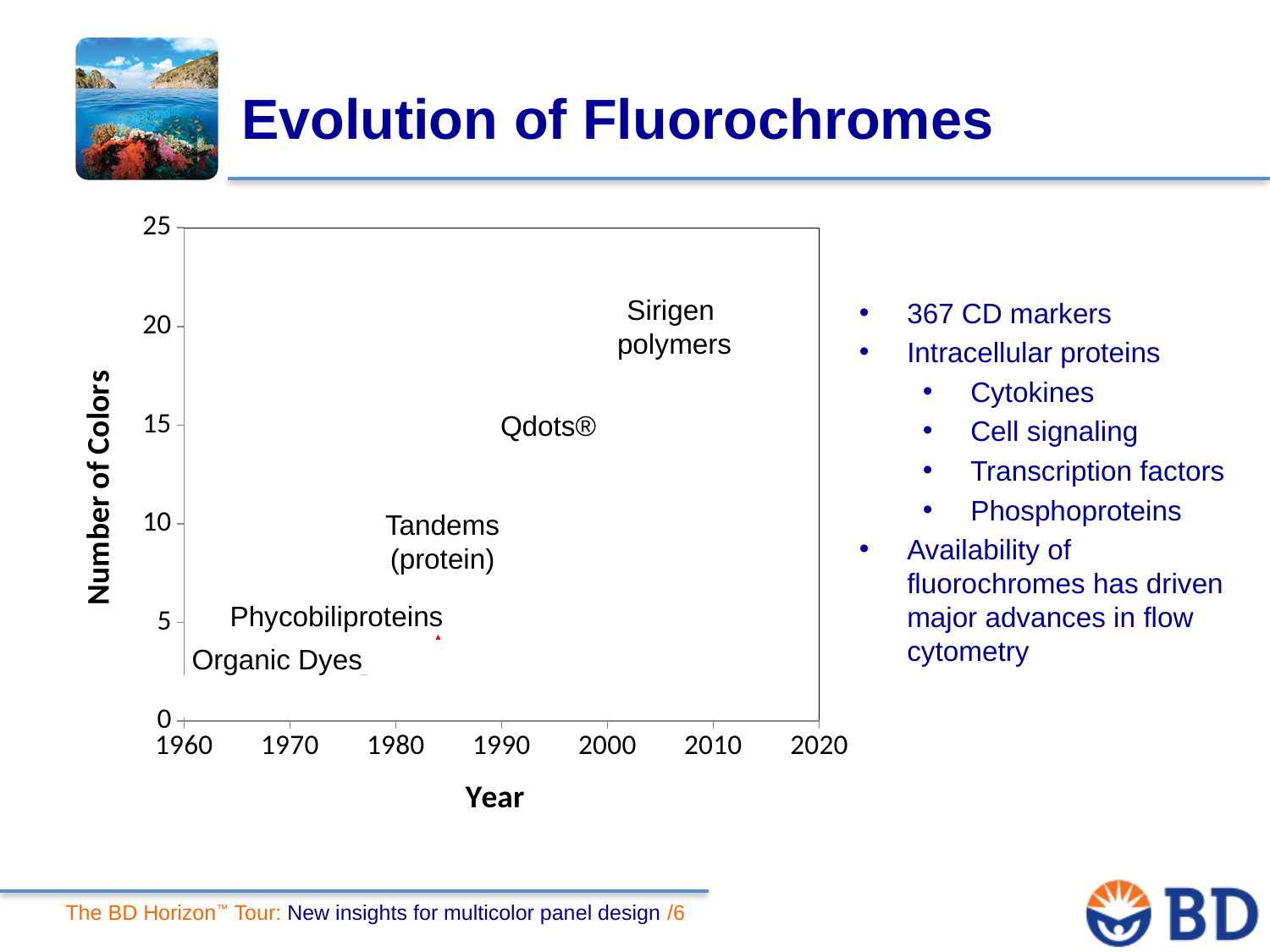
What is the label of the horizontal axis of the chart? Year Which fluorochrome category is placed lowest on the Number of Colors axis? Organic Dyes Is the Number of Colors for Tandems (protein) greater or less than 5? greater Which is placed higher on the Number of Colors axis, Qdots® or Phycobiliproteins? Qdots® Does the Number of Colors rise or fall as the Year increases along the x axis? rise What is the title of the chart on the slide? Evolution of Fluorochromes Is the Number of Colors for Organic Dyes greater or less than 5? less What is the maximum value shown on the Number of Colors axis? 25 How many fluorochrome categories are labeled on the chart? 5 Is the Number of Colors for Sirigen polymers greater or less than 15? greater Which fluorochrome category is placed highest on the Number of Colors axis? Sirigen polymers